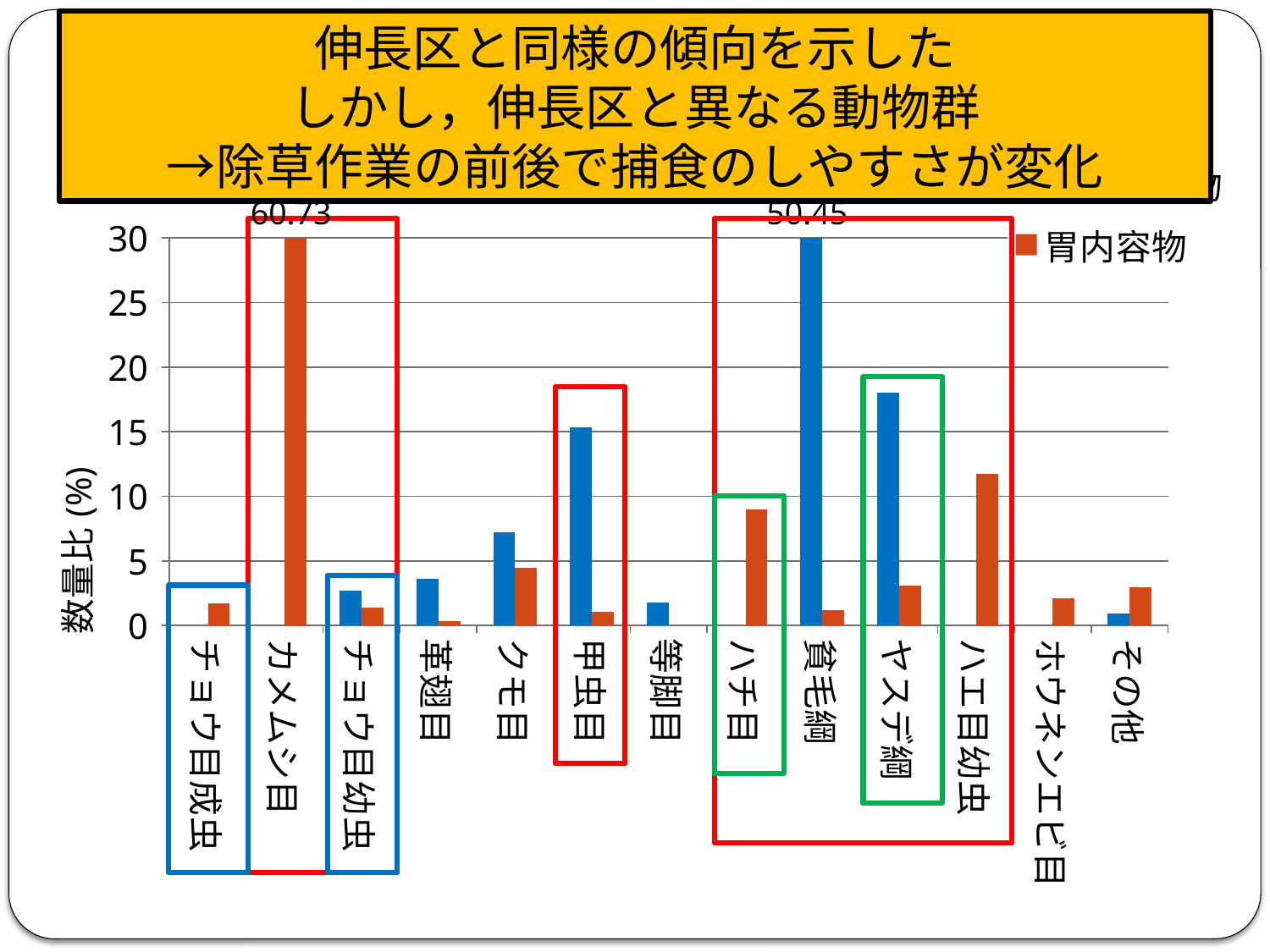
Is the 胃内容物 value for ハエ目幼虫 greater or less than 10? greater What is the 胃内容物 value for カメムシ目? 60.73 For 甲虫目, which bar is larger, the blue bar or the 胃内容物 bar? the blue bar What is the difference between the 胃内容物 value for カメムシ目 and the blue bar value for 貧毛綱? 10.28 Which category has the highest 胃内容物 value? カメムシ目 How many categories are shown on the x axis of the chart? 13 What is the title of the y axis? 数量比 (%) What kind of chart is shown on the slide? bar chart Is the value of the blue bar for ヤスデ綱 greater or less than 15? greater Which series name is visible in the chart legend? 胃内容物 What is the value of the blue bar for 貧毛綱? 50.45 Is the 胃内容物 value for クモ目 greater or less than 5? less